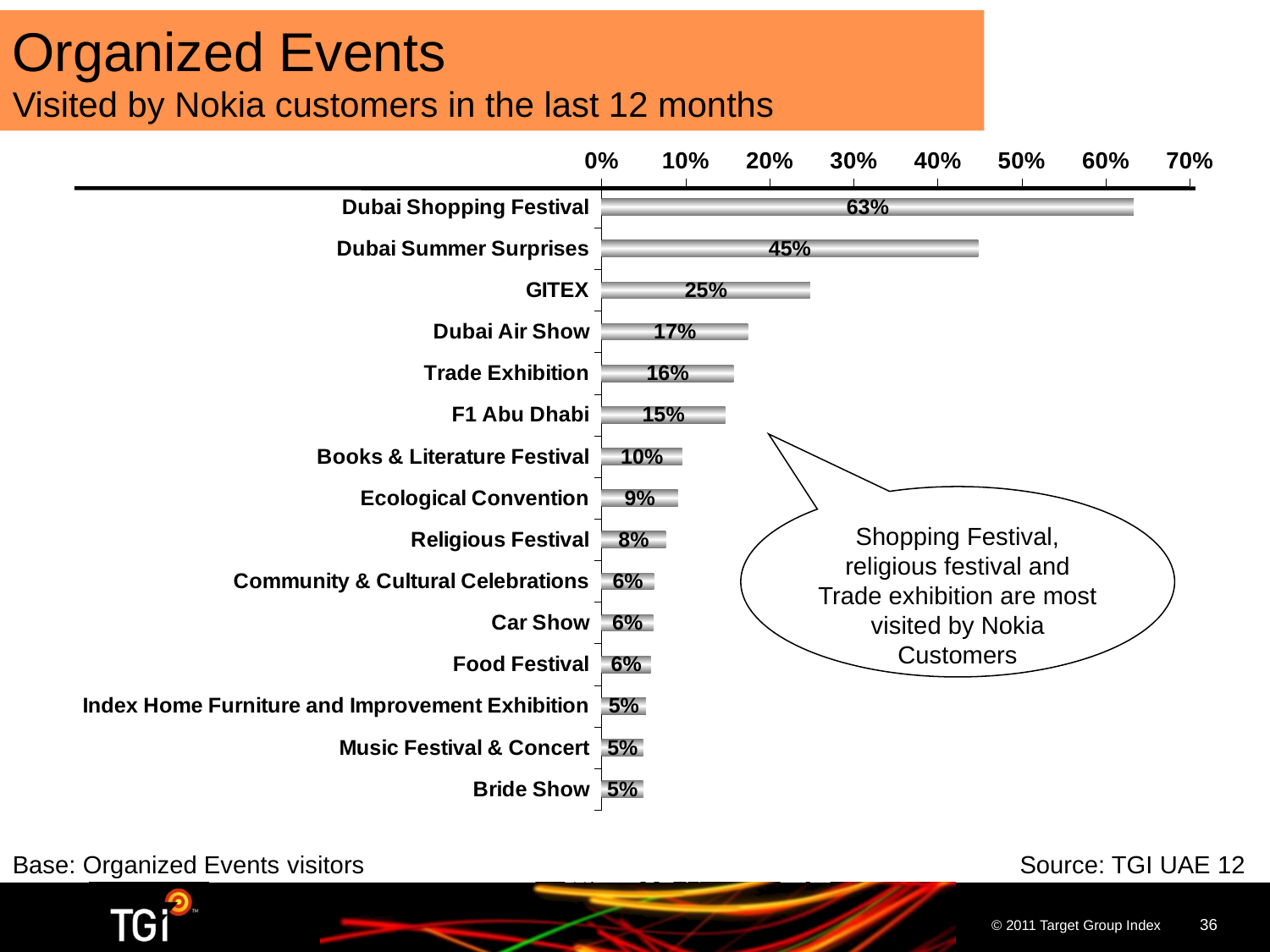
Is the value for Dubai Summer Surprises greater or less than 40%? greater What is the value shown for GITEX? 25% Which has a larger value, Ecological Convention or Religious Festival? Ecological Convention Which event has the highest value on the chart? Dubai Shopping Festival What is the value shown for Books & Literature Festival? 10% How many events are listed on the chart? 15 What is the difference between the values for Dubai Air Show and Trade Exhibition? 1% What kind of chart is shown on the slide? Bar chart What is the value shown for Bride Show? 5% What is the difference between the values for Dubai Shopping Festival and Dubai Summer Surprises? 18% Which has a larger value, GITEX or F1 Abu Dhabi? GITEX What percentage of Nokia customers visited the Dubai Shopping Festival in the last 12 months? 63%